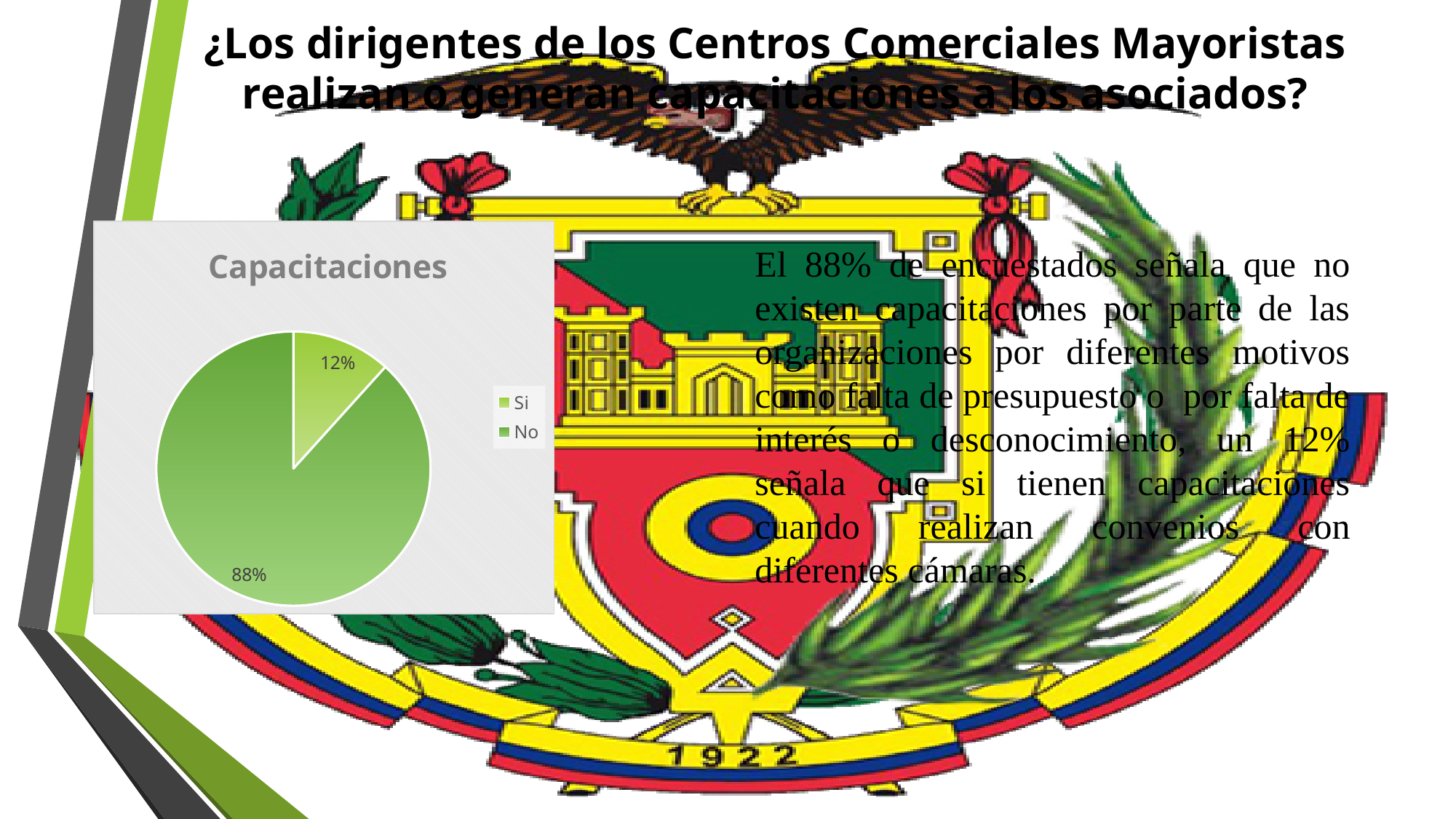
What percentage of the pie does the 'Si' slice represent? 12% How many categories does the legend list? 2 What is the title of the chart? Capacitaciones What percentage of the pie does the 'No' slice represent? 88% Which is larger, the 'Si' slice or the 'No' slice? No Which category has the smallest share of the pie? Si What is the difference in percentage points between the 'No' and 'Si' slices? 76 What are the two legend entries of the chart? Si, No Which category has the largest share of the pie? No What kind of chart is shown on the slide? pie chart Is the share for 'No' greater or less than 50%? greater